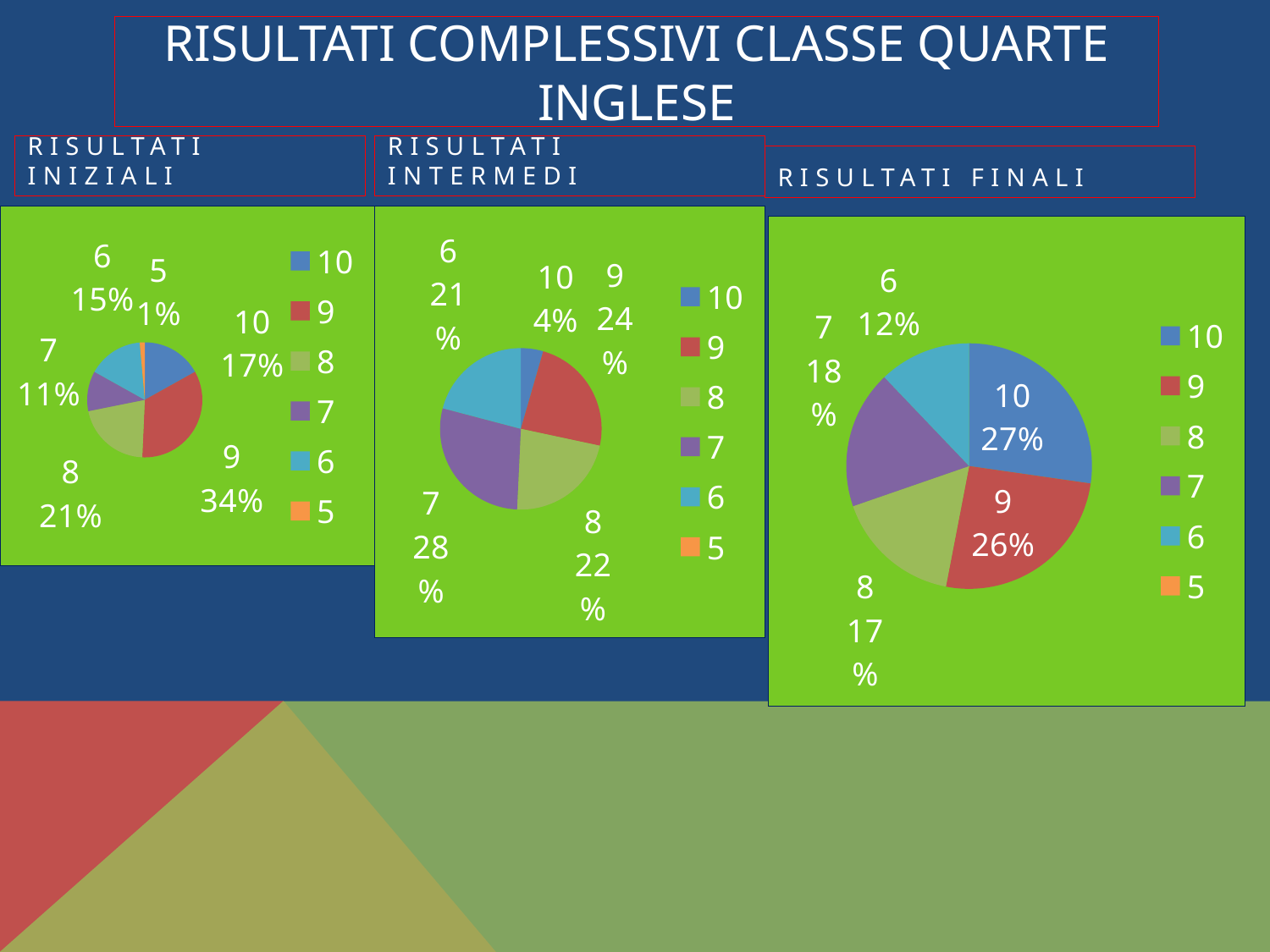
In the RISULTATI INTERMEDI chart, which is larger, the share of grade 9 or the share of grade 8? 9 In the RISULTATI FINALI chart, what share does grade 8 have? 17% How many entries does the legend of the RISULTATI FINALI chart list? 6 In the RISULTATI INIZIALI chart, what share does grade 9 have? 34% In the RISULTATI INTERMEDI chart, what share does grade 7 have? 28% In the RISULTATI INIZIALI chart, what is the difference between the shares of grade 8 and grade 7? 10% In the RISULTATI INIZIALI chart, which grade has the largest slice? 9 In the RISULTATI INTERMEDI chart, which grade has the smallest slice? 10 What kind of chart is shown under RISULTATI INIZIALI? pie chart How many pie charts are shown on the slide? 3 In the RISULTATI INIZIALI chart, which grade has the smallest slice? 5 In the RISULTATI FINALI chart, what is the difference between the shares of grade 7 and grade 6? 6%